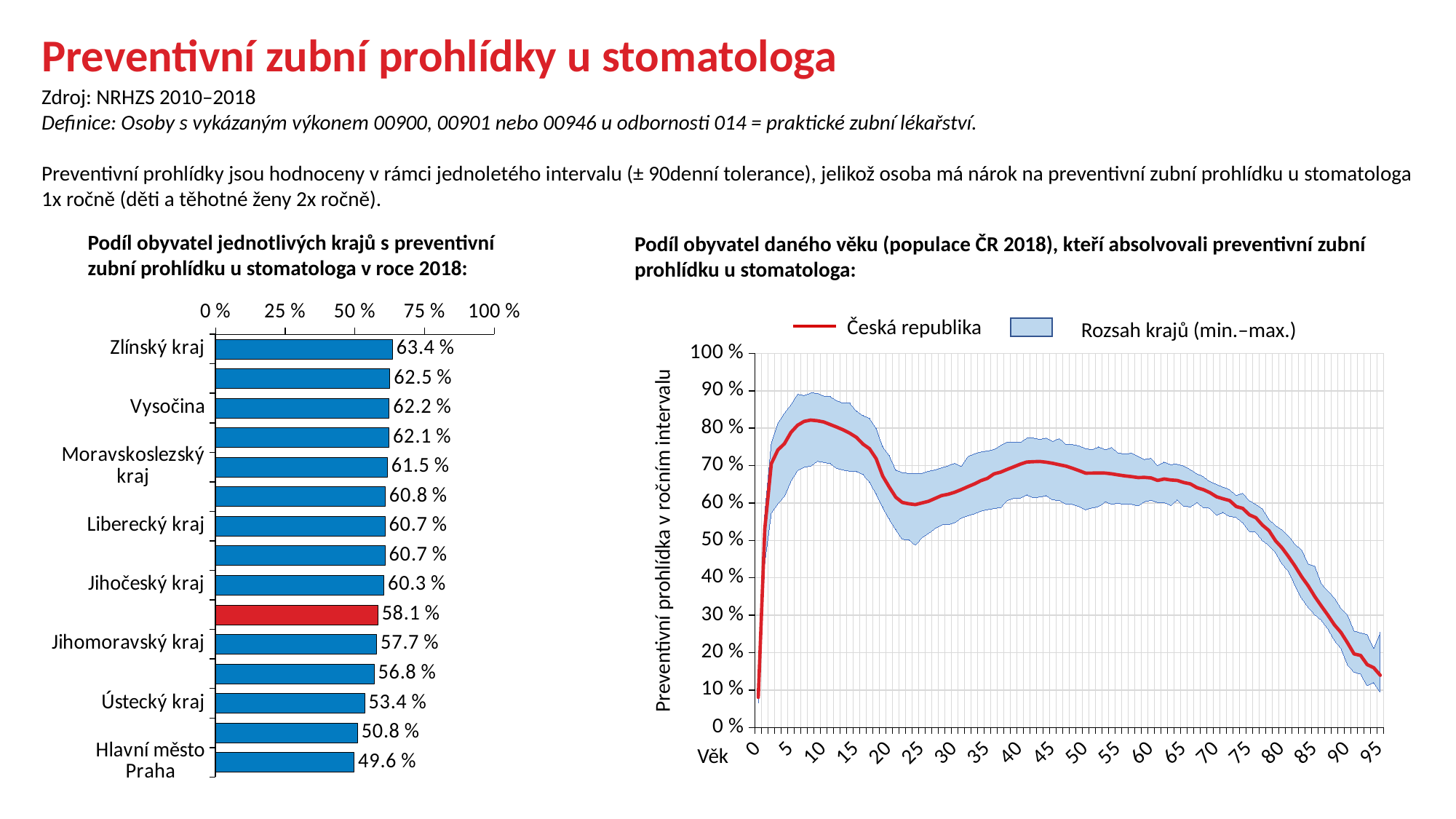
What type of chart is the chart on the left? bar chart In the left bar chart, what is the value for Hlavní město Praha? 49.6 % In the left bar chart, what is the value for Ústecký kraj? 53.4 % In the right chart, is the Česká republika value at age 25 greater or less than 70 %? less In the left bar chart, which is larger: Jihočeský kraj or Jihomoravský kraj? Jihočeský kraj In the left bar chart, which region has the highest share? Zlínský kraj In the left bar chart, what is the value for Zlínský kraj? 63.4 % How many entries does the legend of the right chart list? 2 How many bars are in the left bar chart? 15 In the left bar chart, what is the value of the red bar? 58.1 % In the left bar chart, which region has the lowest share? Hlavní město Praha In the left bar chart, what is the difference between Zlínský kraj and Hlavní město Praha? 13.8 %